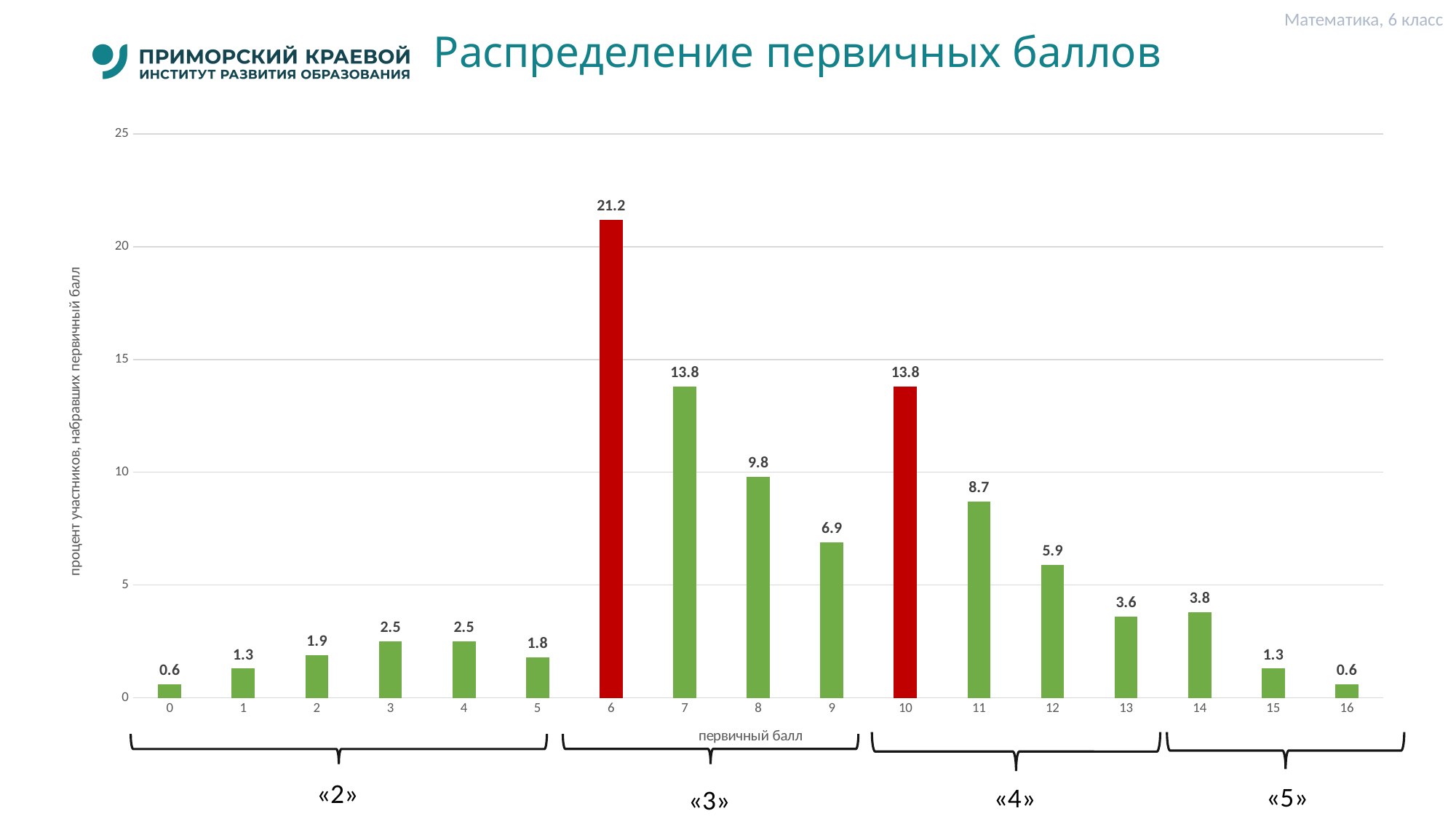
Which primary scores are drawn with red bars? 6 and 10 Which primary score has the highest percentage of participants? 6 Which primary scores share the lowest value on the chart? 0 and 16 Which has a larger value: primary score 11 or primary score 12? 11 Is the value for primary score 10 greater or less than 15? less What is the difference between the values for primary score 6 and primary score 7? 7.4 What is the value shown for primary score 14? 3.8 What is the value shown for primary score 11? 8.7 What is the difference between the values for primary score 8 and primary score 9? 2.9 What percentage of participants scored a primary score of 6? 21.2 What type of chart is shown on the slide? bar chart How many primary score categories are shown on the x axis? 17